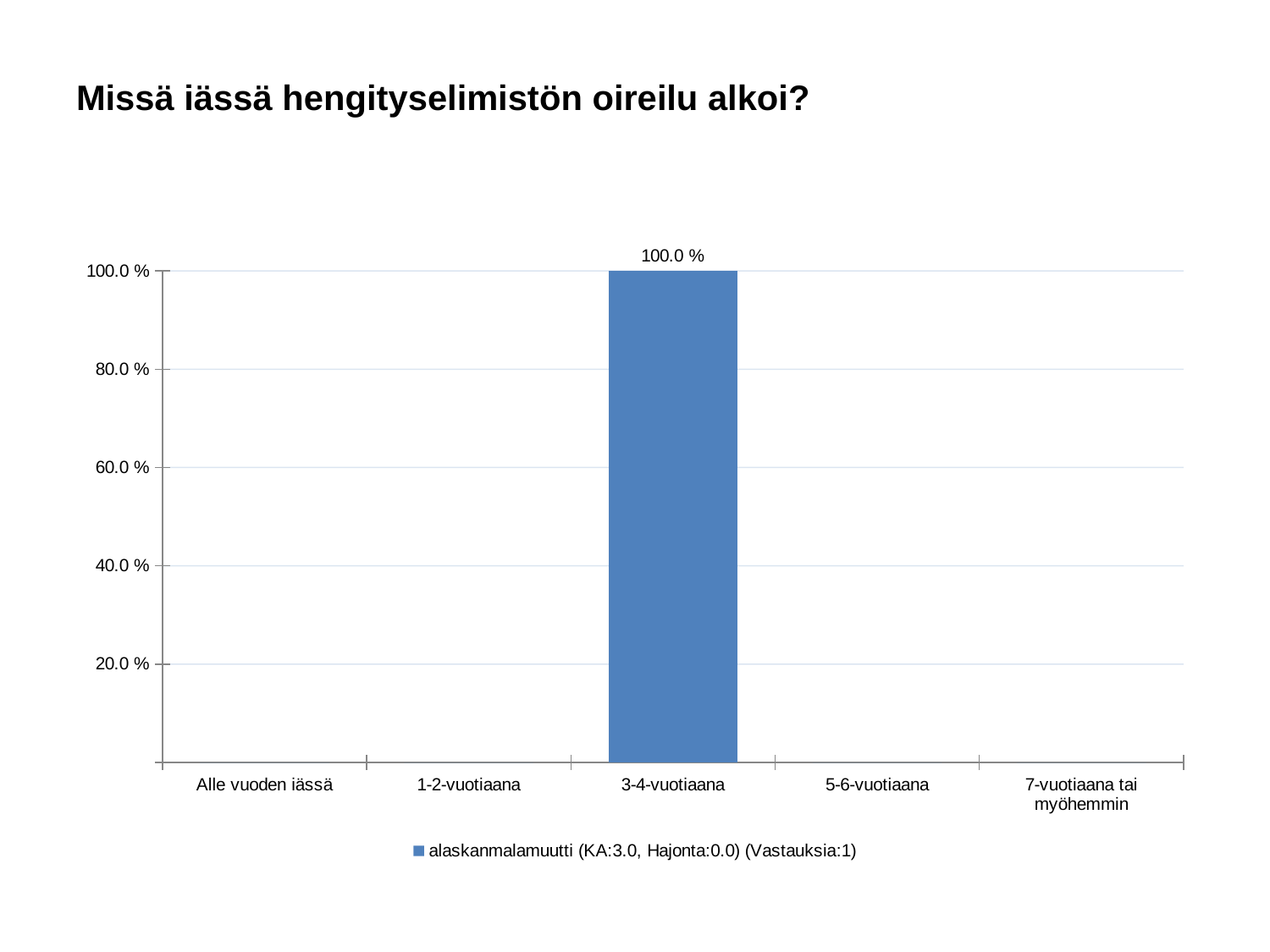
What kind of chart is shown on the slide? bar chart Which category has the highest value? 3-4-vuotiaana What is the title of the chart? Missä iässä hengityselimistön oireilu alkoi? What is the value for 3-4-vuotiaana? 100.0 % How many categories are shown on the x axis? 5 How many categories have a visible bar? 1 What is the legend entry for the series? alaskanmalamuutti (KA:3.0, Hajonta:0.0) (Vastauksia:1) Is the value for 3-4-vuotiaana greater or less than 80.0 %? greater How many series does the legend list? 1 What is the label of the last category on the x axis? 7-vuotiaana tai myöhemmin Which is larger, the value for 3-4-vuotiaana or the value for 5-6-vuotiaana? 3-4-vuotiaana